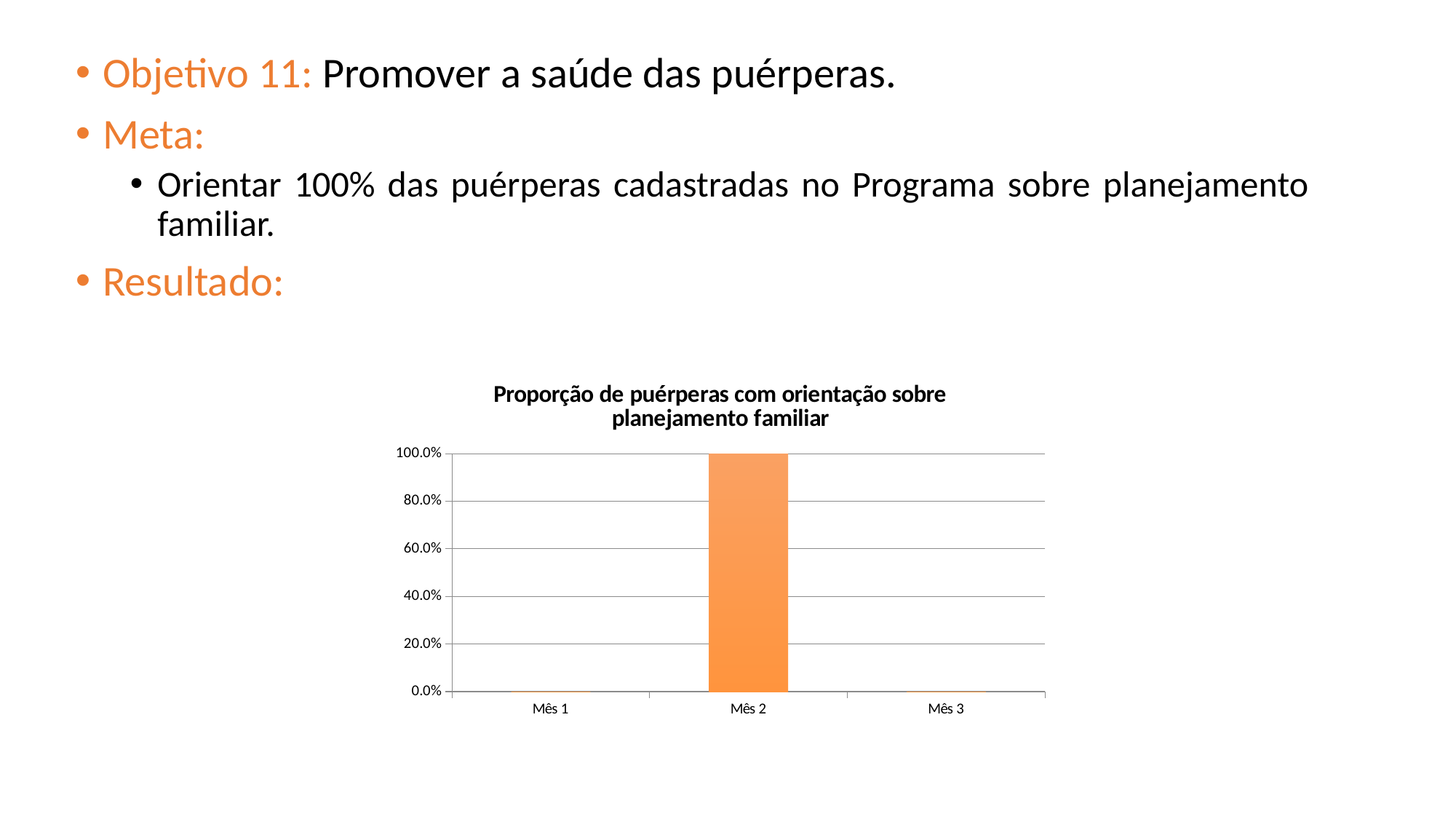
How many categories are shown on the x axis of the chart? 3 Is the value for Mês 3 greater or less than 20.0%? less What is the value for Mês 2 in the chart? 100.0% Which is larger, the value for Mês 1 or the value for Mês 2? Mês 2 What kind of chart is shown on the slide? bar chart Which is larger, the value for Mês 2 or the value for Mês 3? Mês 2 Which month has the highest value in the chart? Mês 2 What is the highest value shown on the y axis of the chart? 100.0% Is the value for Mês 2 greater or less than 80.0%? greater What is the title of the chart? Proporção de puérperas com orientação sobre planejamento familiar Is the value for Mês 1 greater or less than 20.0%? less